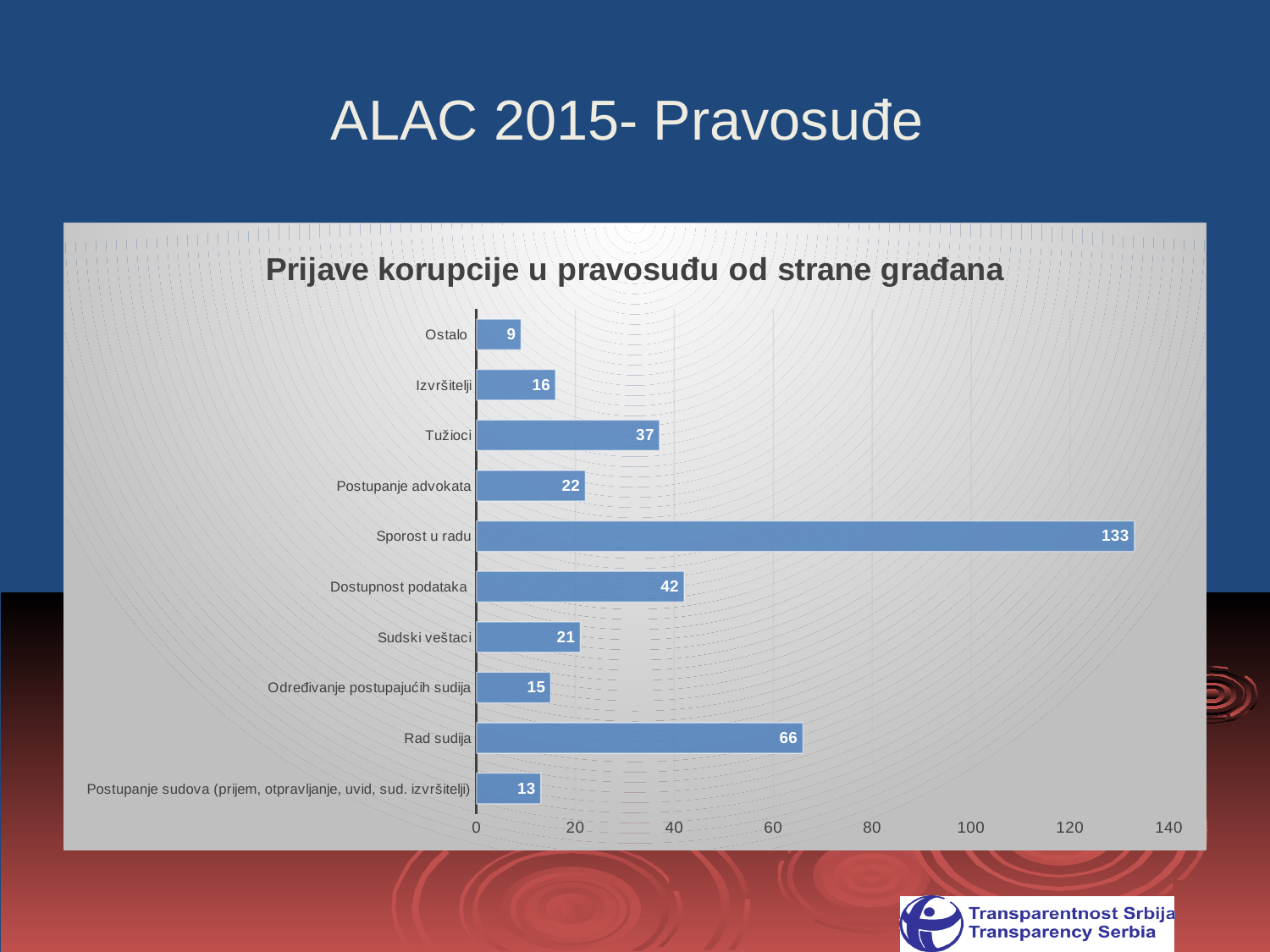
What is the value for Sporost u radu? 133 Which category has the highest value? Sporost u radu What kind of chart is shown on the slide? Bar chart What is the title of the chart? Prijave korupcije u pravosuđu od strane građana How many categories are shown in the chart? 10 What is the difference between the values for Sporost u radu and Rad sudija? 67 Which category has the lowest value? Ostalo What is the value for Tužioci? 37 Is the value for Rad sudija greater or less than 60? greater Which is larger, the value for Dostupnost podataka or the value for Tužioci? Dostupnost podataka What is the value for Postupanje sudova (prijem, otpravljanje, uvid, sud. izvršitelji)? 13 What is the value for Rad sudija? 66